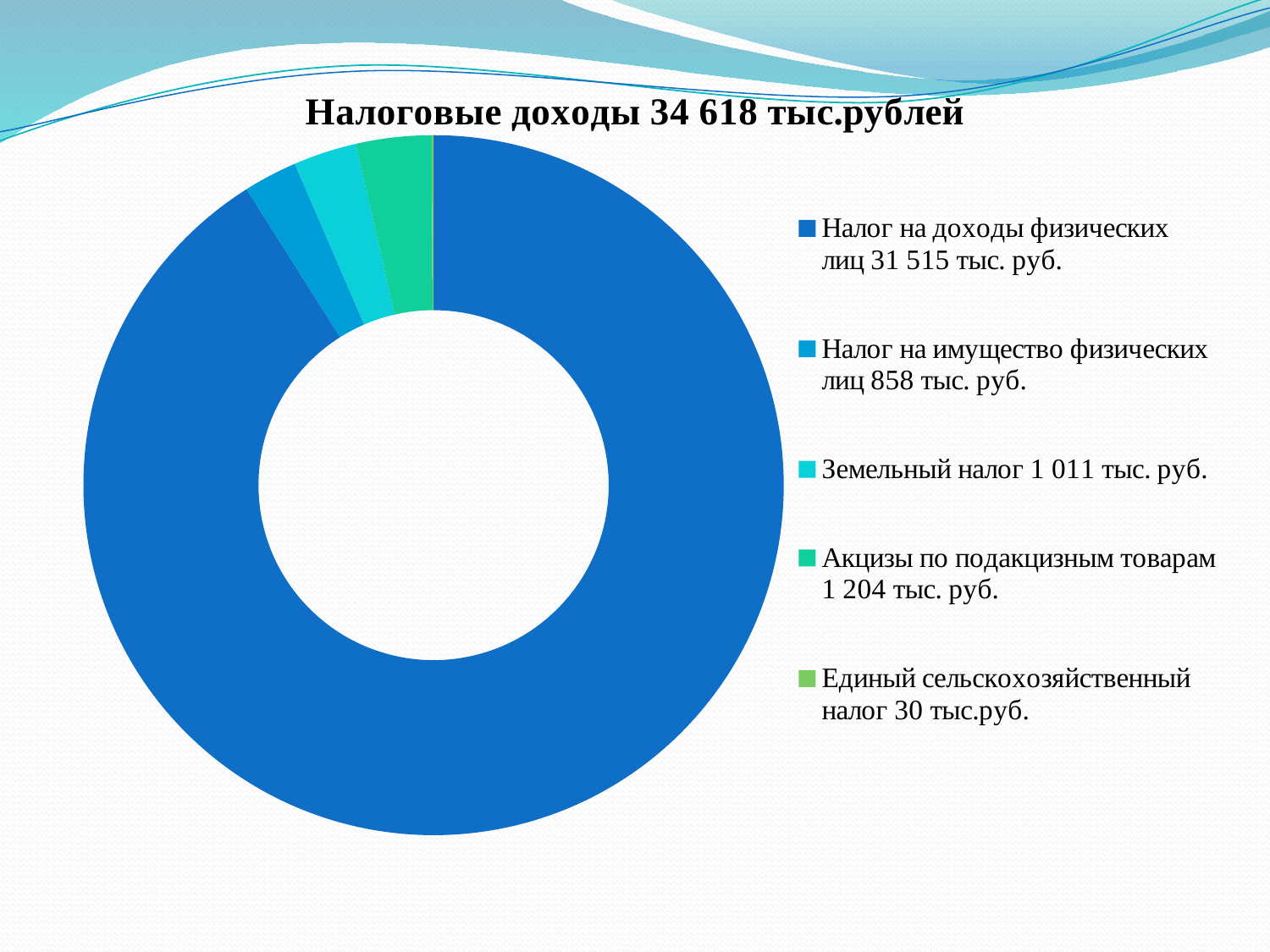
What is the difference between Акцизы по подакцизным товарам and Земельный налог? 193 тыс. руб. What is the value for Налог на имущество физических лиц? 858 тыс. руб. What is the value for Акцизы по подакцизным товарам? 1 204 тыс. руб. How many categories does the chart's legend list? 5 Which category has the smallest value? Единый сельскохозяйственный налог Which is larger, Акцизы по подакцизным товарам or Земельный налог? Акцизы по подакцизным товарам What kind of chart is shown on the slide? Doughnut (pie) chart Which category has the largest value? Налог на доходы физических лиц What is the title of the chart? Налоговые доходы 34 618 тыс.рублей What is the value for Единый сельскохозяйственный налог? 30 тыс.руб. What is the value for Налог на доходы физических лиц? 31 515 тыс. руб. What is the value for Земельный налог? 1 011 тыс. руб.